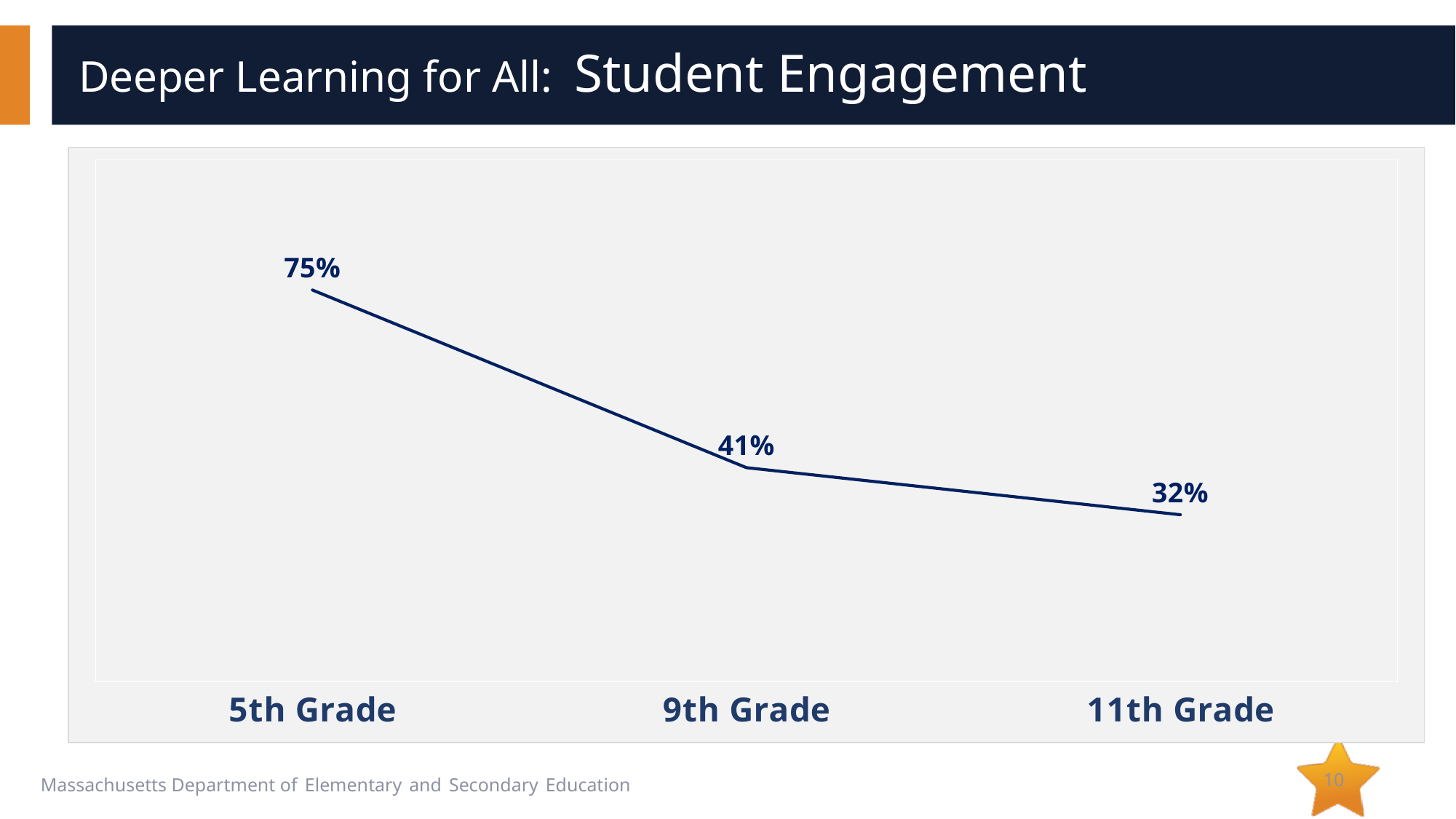
Which is larger, the value for 9th Grade or the value for 11th Grade? 9th Grade Which grade has the lowest value? 11th Grade What is the difference between the values for 5th Grade and 11th Grade? 43% How many grade levels are plotted on the chart? 3 What is the difference between the values for 9th Grade and 11th Grade? 9% What is the value for 9th Grade? 41% What is the value for 11th Grade? 32% What is the value for 5th Grade? 75% Do the values rise or fall from 5th Grade to 11th Grade? fall What kind of chart is shown on the slide? line chart Which grade has the highest value? 5th Grade What is the difference between the values for 5th Grade and 9th Grade? 34%